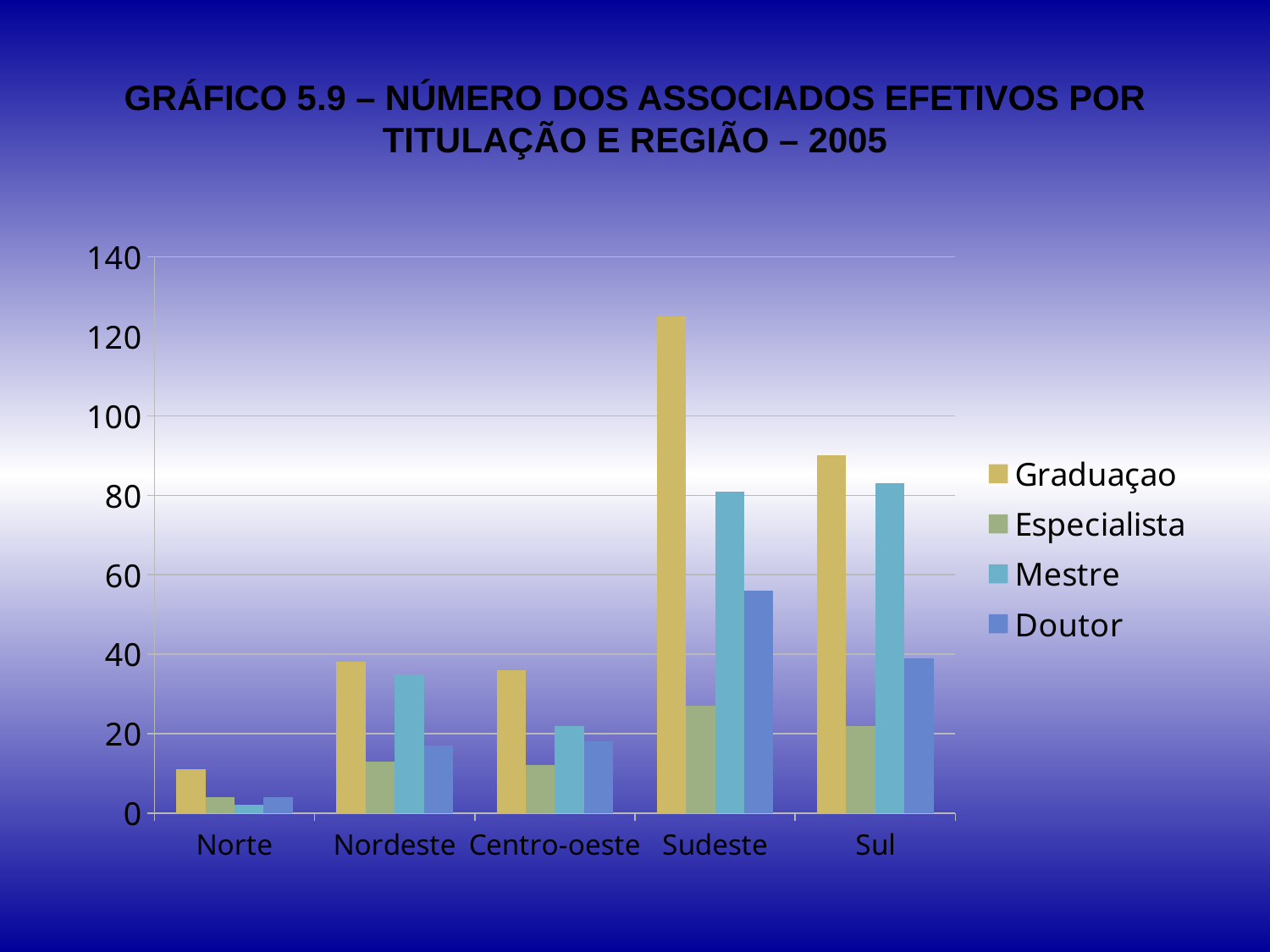
How many regions are shown on the x axis? 5 Which region has the lowest Graduaçao value? Norte What kind of chart is shown on the slide? bar chart How many series does the legend list? 4 Is the Graduaçao value for Sudeste greater or less than 120? greater Which region has the lowest Mestre value? Norte In Sudeste, which is larger: the Mestre value or the Doutor value? Mestre Which region has the highest Doutor value? Sudeste Is the Mestre value for Sul greater or less than 60? greater In Centro-oeste, which is larger: the Graduaçao value or the Mestre value? Graduaçao Which region has the highest Graduaçao value? Sudeste Is the Doutor value for Sudeste greater or less than 40? greater